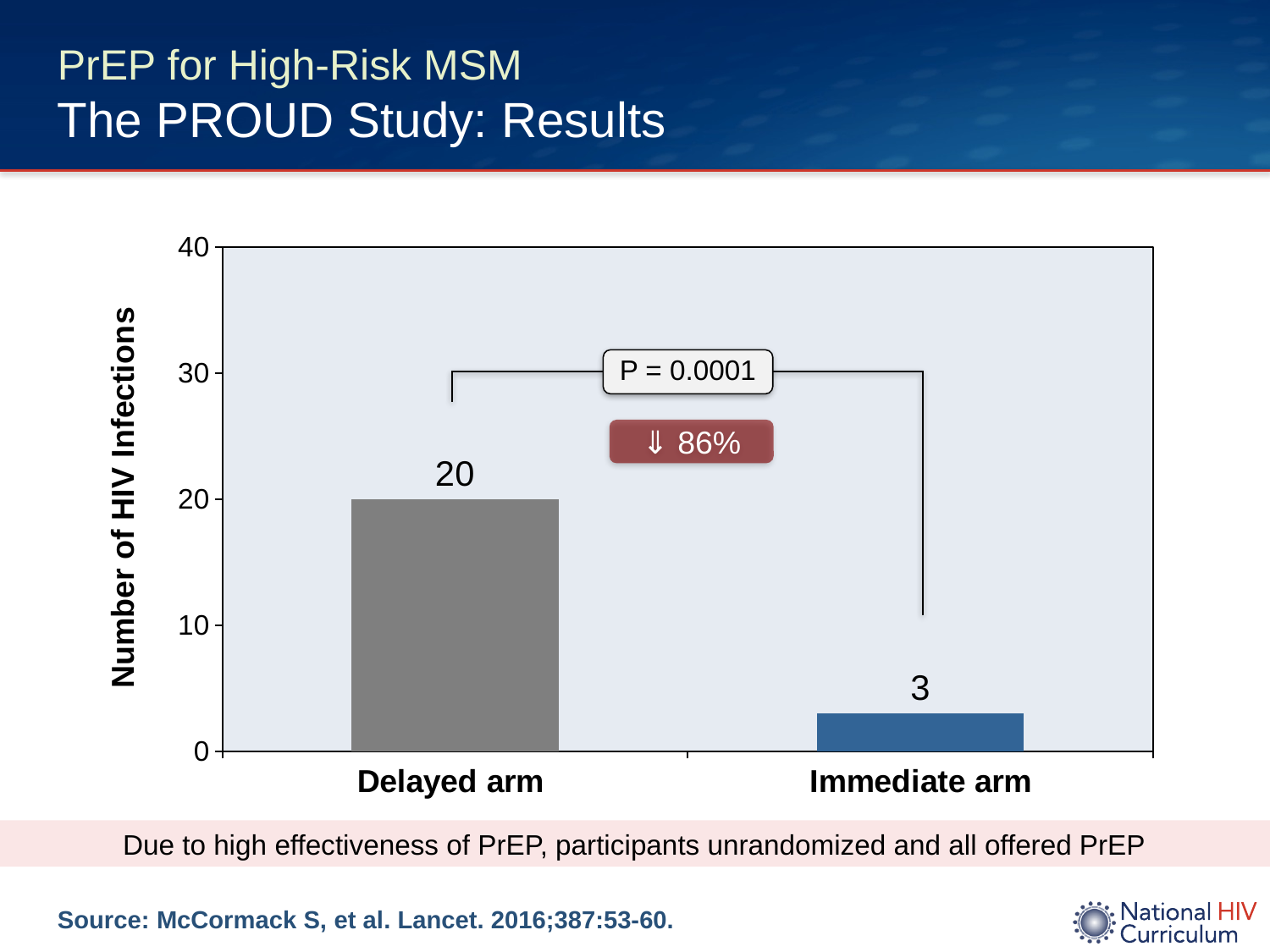
What P value is shown on the chart? P = 0.0001 What is the label of the y axis? Number of HIV Infections Which arm has the lower number of HIV infections? Immediate arm Is the value for the Delayed arm greater or less than 10? greater What is the number of HIV infections in the Immediate arm? 3 How many categories are shown on the x axis of the chart? 2 Is the number of HIV infections larger in the Immediate arm or the Delayed arm? Delayed arm What is the difference in the number of HIV infections between the Delayed arm and the Immediate arm? 17 What is the number of HIV infections in the Delayed arm? 20 What kind of chart is shown on the slide? bar chart Which arm has the higher number of HIV infections? Delayed arm What is the maximum value shown on the y axis? 40